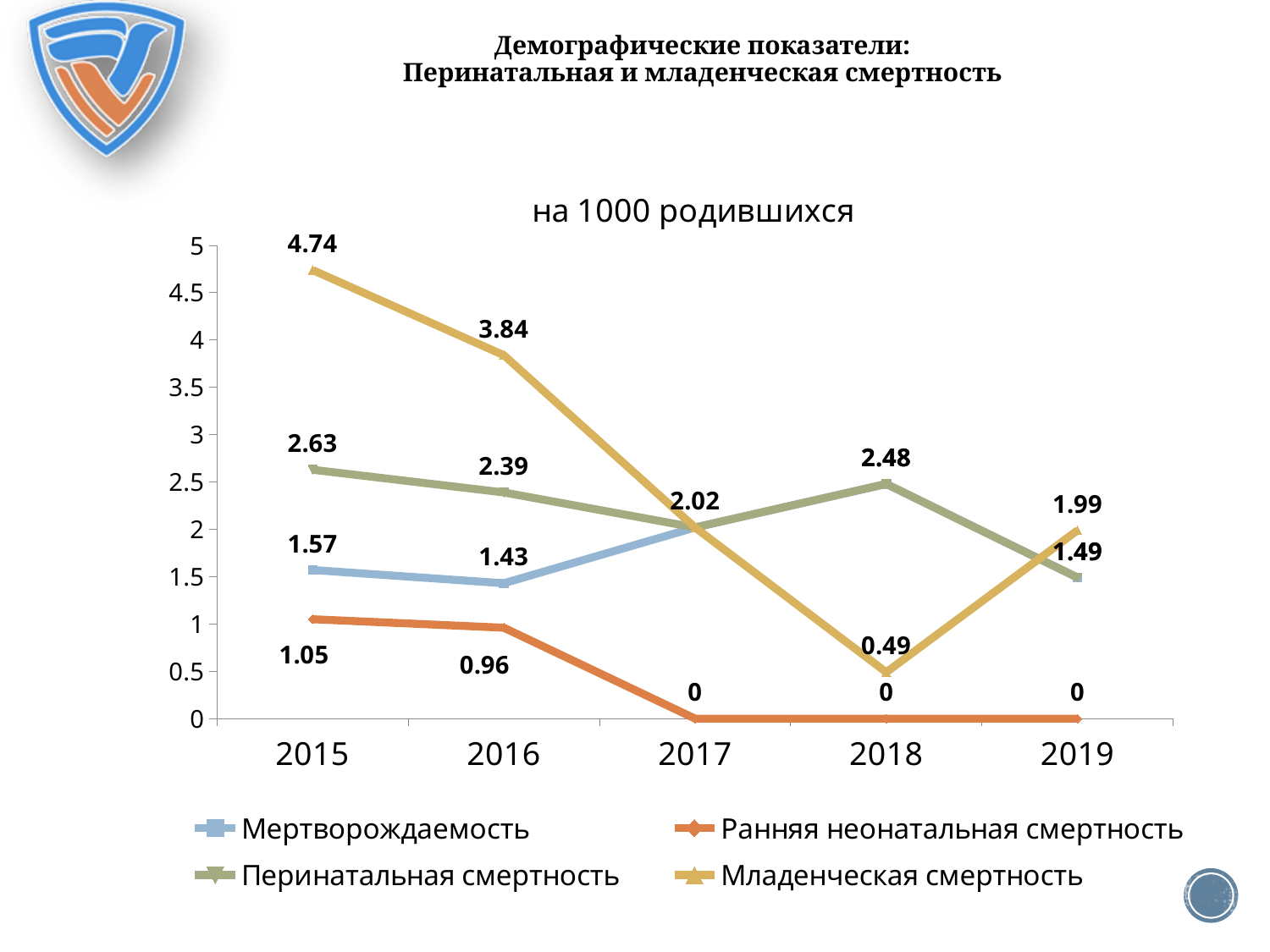
In which year is Младенческая смертность at its lowest? 2018 What is the value of Перинатальная смертность in 2018? 2.48 How many years are shown on the x axis? 5 Which is larger in 2015: Перинатальная смертность or Мертворождаемость? Перинатальная смертность What is the title of the chart? на 1000 родившихся In which year is Младенческая смертность at its highest? 2015 How many series does the legend list? 4 What is the value of Ранняя неонатальная смертность in 2019? 0 What is the value of Мертворождаемость in 2016? 1.43 What is the difference between Младенческая смертность in 2015 and 2016? 0.9 What type of chart is shown on the slide? line chart What is the value of Младенческая смертность in 2015? 4.74